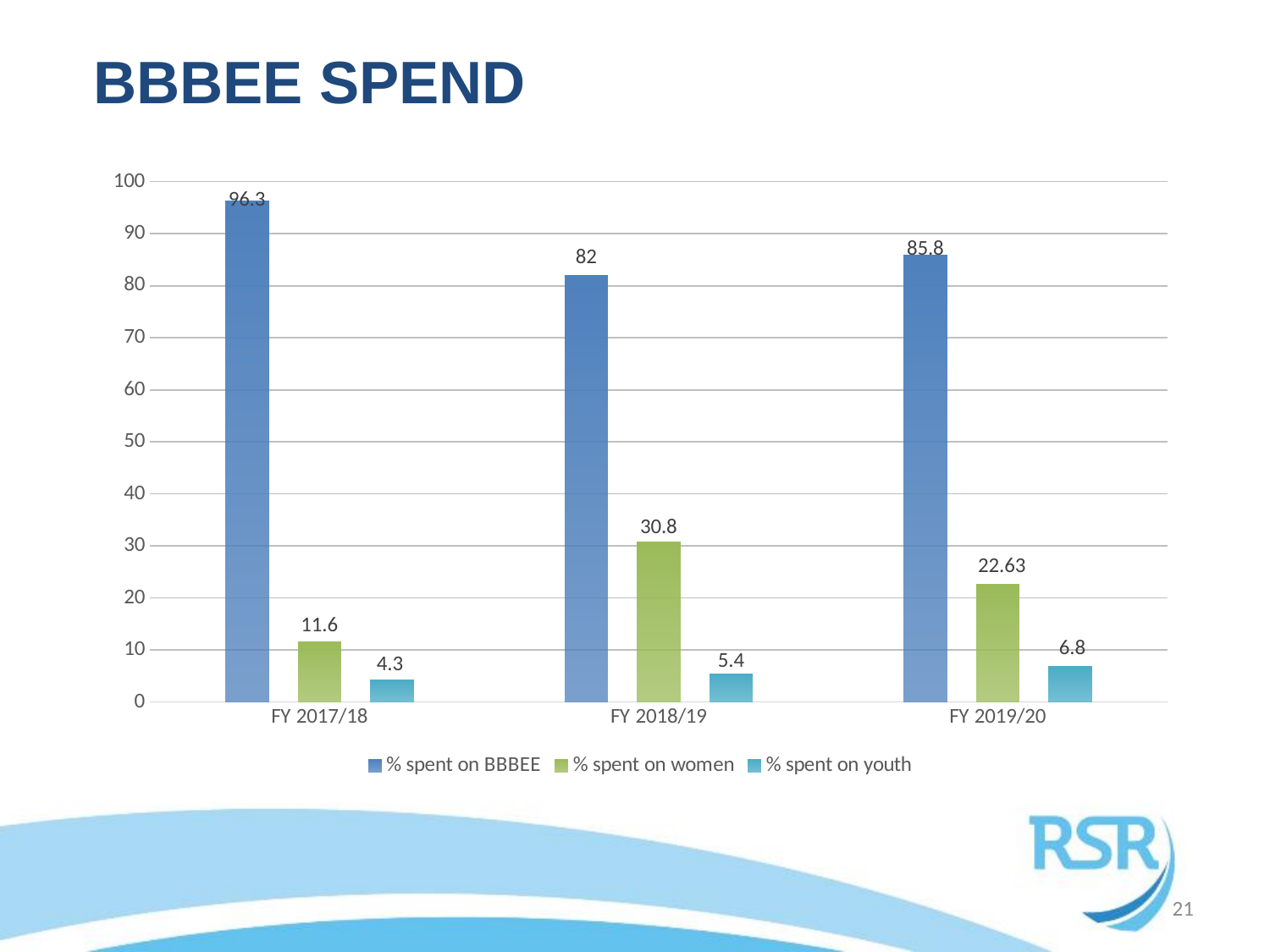
In which fiscal year is % spent on women highest? FY 2018/19 Which is larger: % spent on youth in FY 2018/19 or in FY 2019/20? FY 2019/20 What is the difference between % spent on BBBEE in FY 2017/18 and FY 2018/19? 14.3 What is the value for % spent on women in FY 2018/19? 30.8 What is the value for % spent on women in FY 2019/20? 22.63 How many series does the legend list? 3 How many fiscal years are shown on the x axis? 3 What is the value for % spent on youth in FY 2019/20? 6.8 What kind of chart is shown on the slide? Bar chart In which fiscal year is % spent on BBBEE lowest? FY 2018/19 What is the value for % spent on BBBEE in FY 2017/18? 96.3 What is the title of the slide? BBBEE SPEND